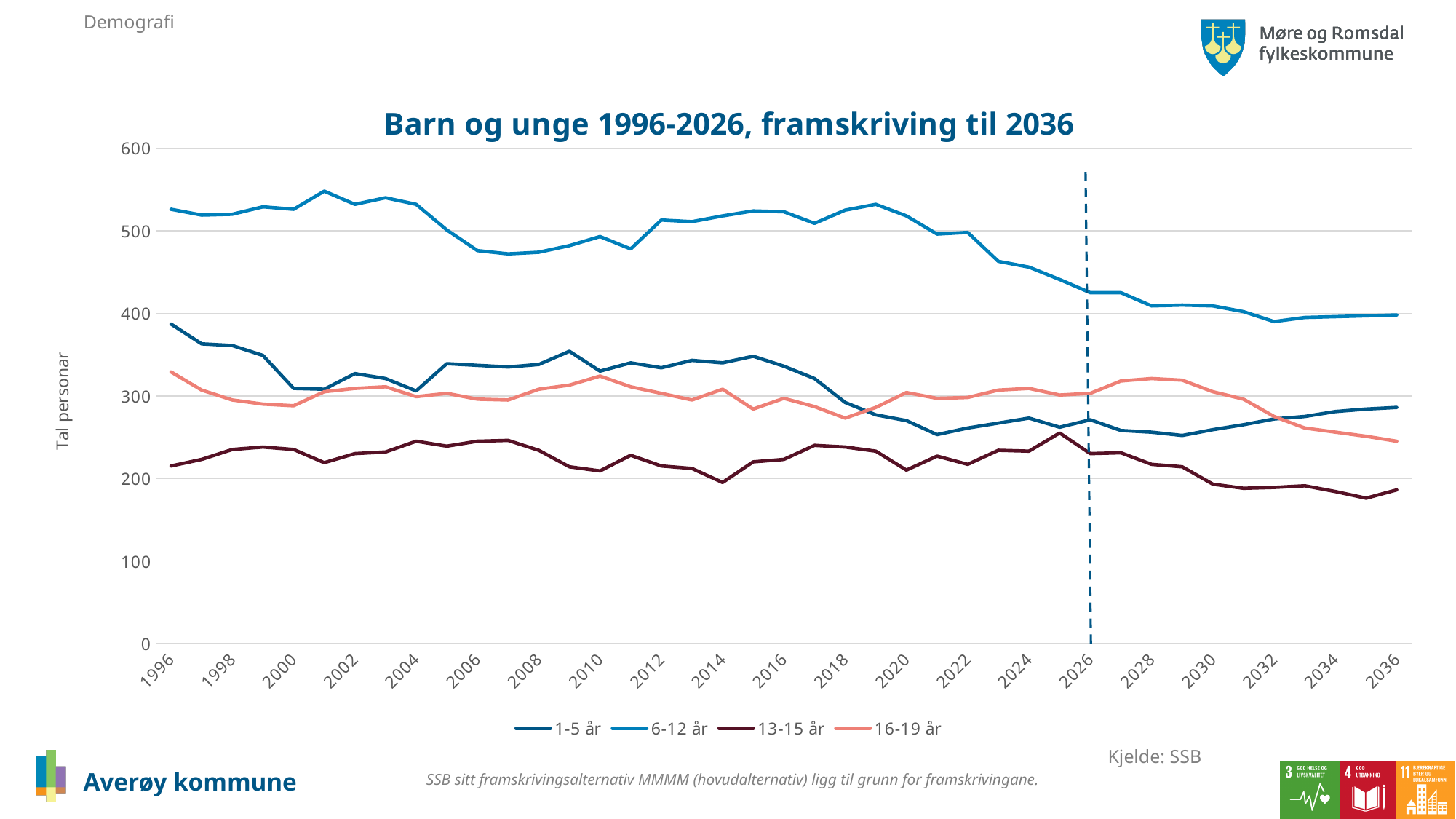
In 2036, which is larger: the value for 1-5 år or the value for 16-19 år? 1-5 år Is the value for 6-12 år in 1996 greater or less than 500? greater Is the value for 6-12 år in 2026 greater or less than 400? greater How many series does the legend list? 4 What kind of chart is shown on the slide? line chart Which series has the lowest values across the whole period? 13-15 år Is the value for 13-15 år in 2036 greater or less than 200? less Which series has the highest values across the whole period? 6-12 år What is the title of the chart? Barn og unge 1996-2026, framskriving til 2036 Does the 6-12 år series rise or fall from 2026 to 2036? fall What is the label on the y axis? Tal personar